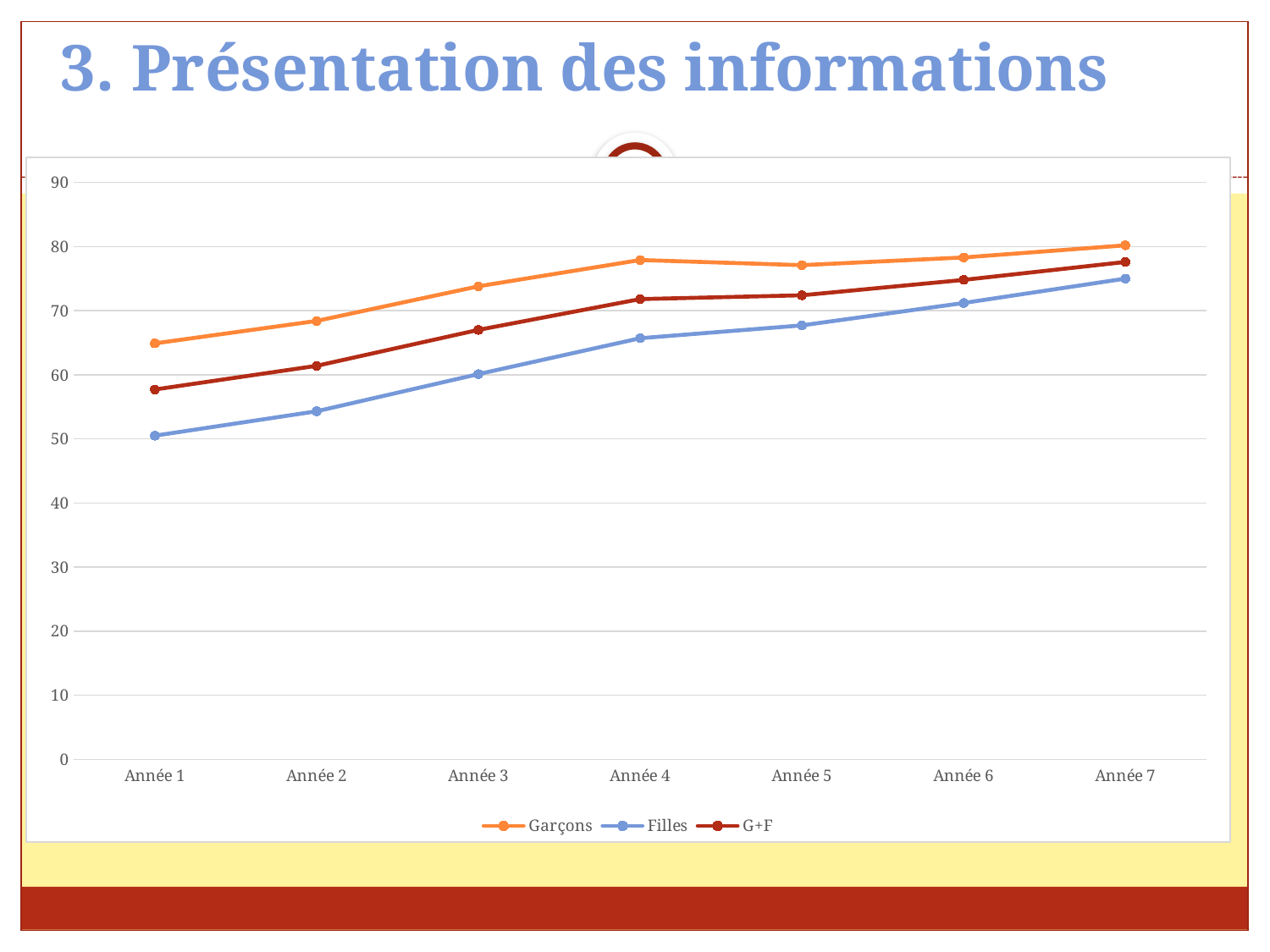
Do the values for Filles rise or fall from Année 1 to Année 7? rise In which year does the Garçons series have its lowest value? Année 1 In which year does the Filles series reach its highest value? Année 7 Is the value for Filles at Année 1 greater or less than 60? less Which series does the legend list: name them in order. Garçons, Filles, G+F Is the value for G+F at Année 4 greater or less than 70? greater How many series does the legend list? 3 What kind of chart is shown on the slide? line chart Is the value for Filles at Année 3 greater or less than 70? less How many categories (years) are plotted along the x axis? 7 At Année 4, which is larger: the value for Garçons or the value for Filles? Garçons